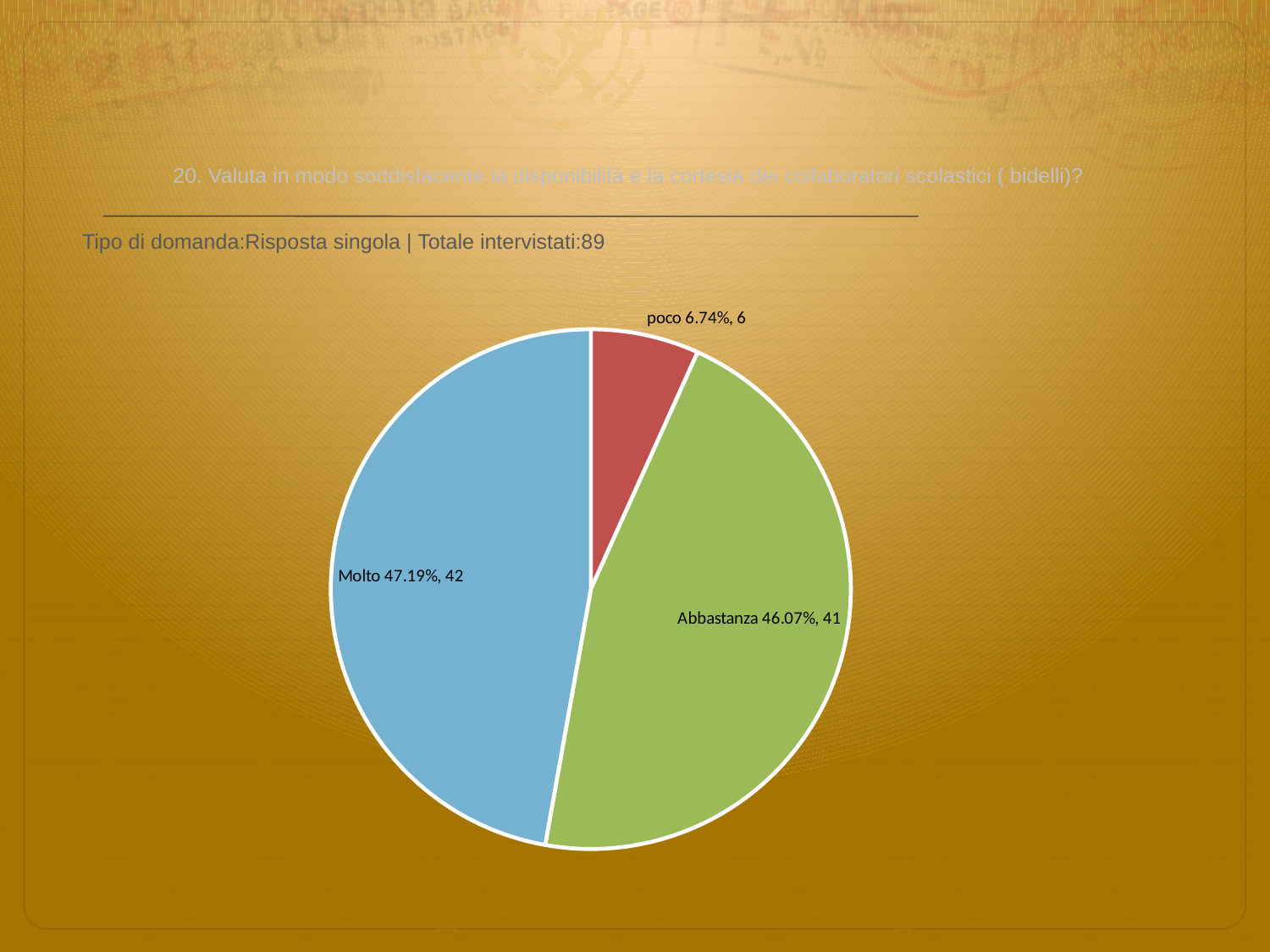
How many respondents answered "poco"? 6 How many slices does the pie chart have? 3 What colour is the "Abbastanza" slice? green What kind of chart is shown on the slide? pie chart What percentage share does the "Molto" slice have? 47.19% What percentage share does the "poco" slice have? 6.74% Which response category has the smallest slice? poco How many respondents answered "Molto"? 42 How many respondents answered "Abbastanza"? 41 Which response category has the largest slice? Molto What is the difference in respondent count between "Molto" and "poco"? 36 What percentage share does the "Abbastanza" slice have? 46.07%